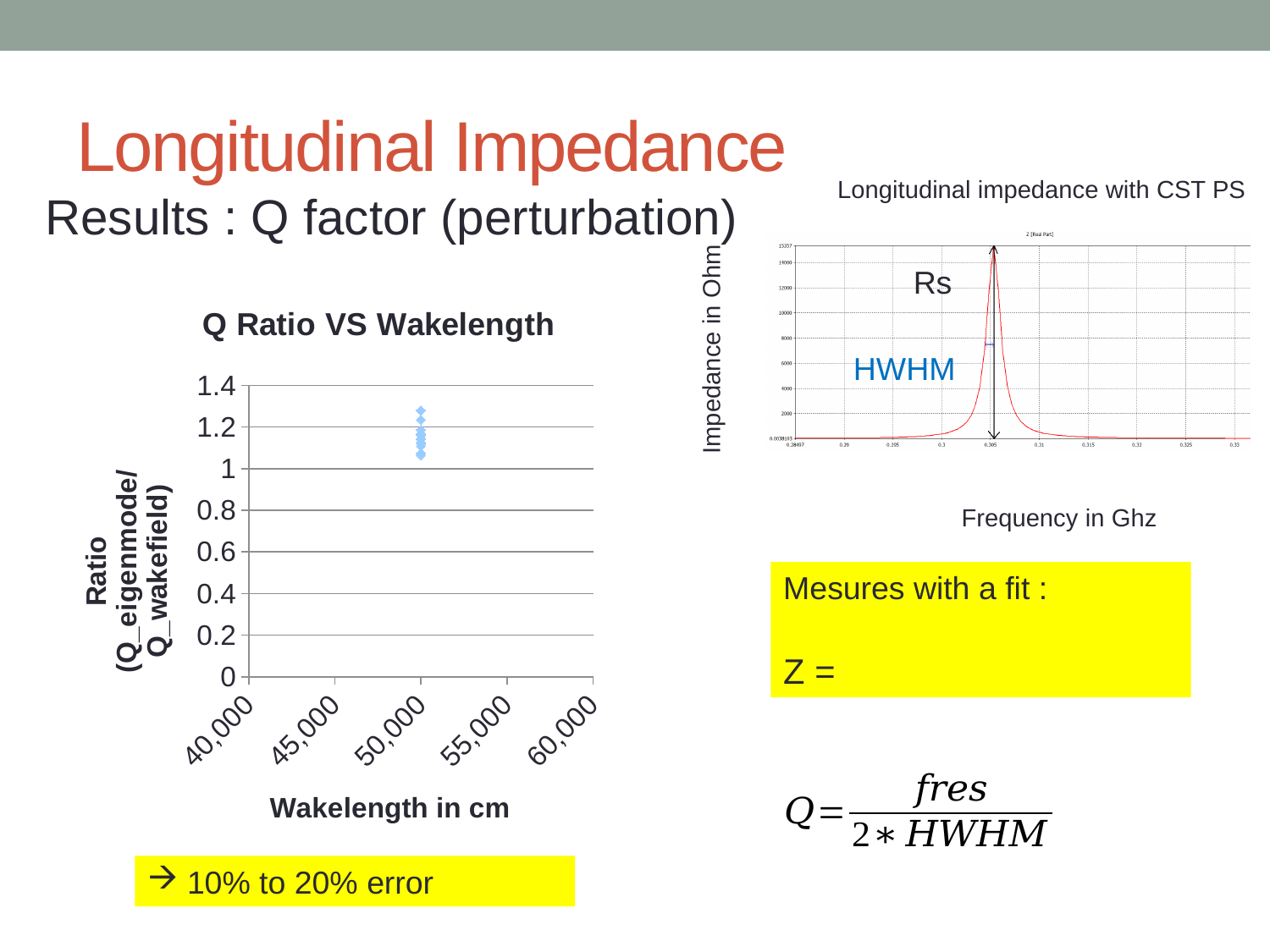
What is the title of the chart on the left of the slide? Q Ratio VS Wakelength In the 'Longitudinal impedance with CST PS' chart, is the impedance at 0.29 GHz greater or less than 2000? less In the 'Longitudinal impedance with CST PS' chart, what is the x-axis label? Frequency in Ghz What kind of chart is the 'Longitudinal impedance with CST PS' chart on the right? line chart In the 'Longitudinal impedance with CST PS' chart, is the peak impedance greater or less than 14000? greater In the 'Q Ratio VS Wakelength' chart, at which wakelength tick are all the points clustered? 50,000 In the 'Q Ratio VS Wakelength' chart, are the plotted ratio values greater or less than 1.4? less What kind of chart is the 'Q Ratio VS Wakelength' chart on the left? scatter chart How many tick labels are shown on the x axis of the 'Q Ratio VS Wakelength' chart? 5 In the 'Q Ratio VS Wakelength' chart, what is the x-axis title? Wakelength in cm In the 'Q Ratio VS Wakelength' chart, what is the highest value shown on the y axis? 1.4